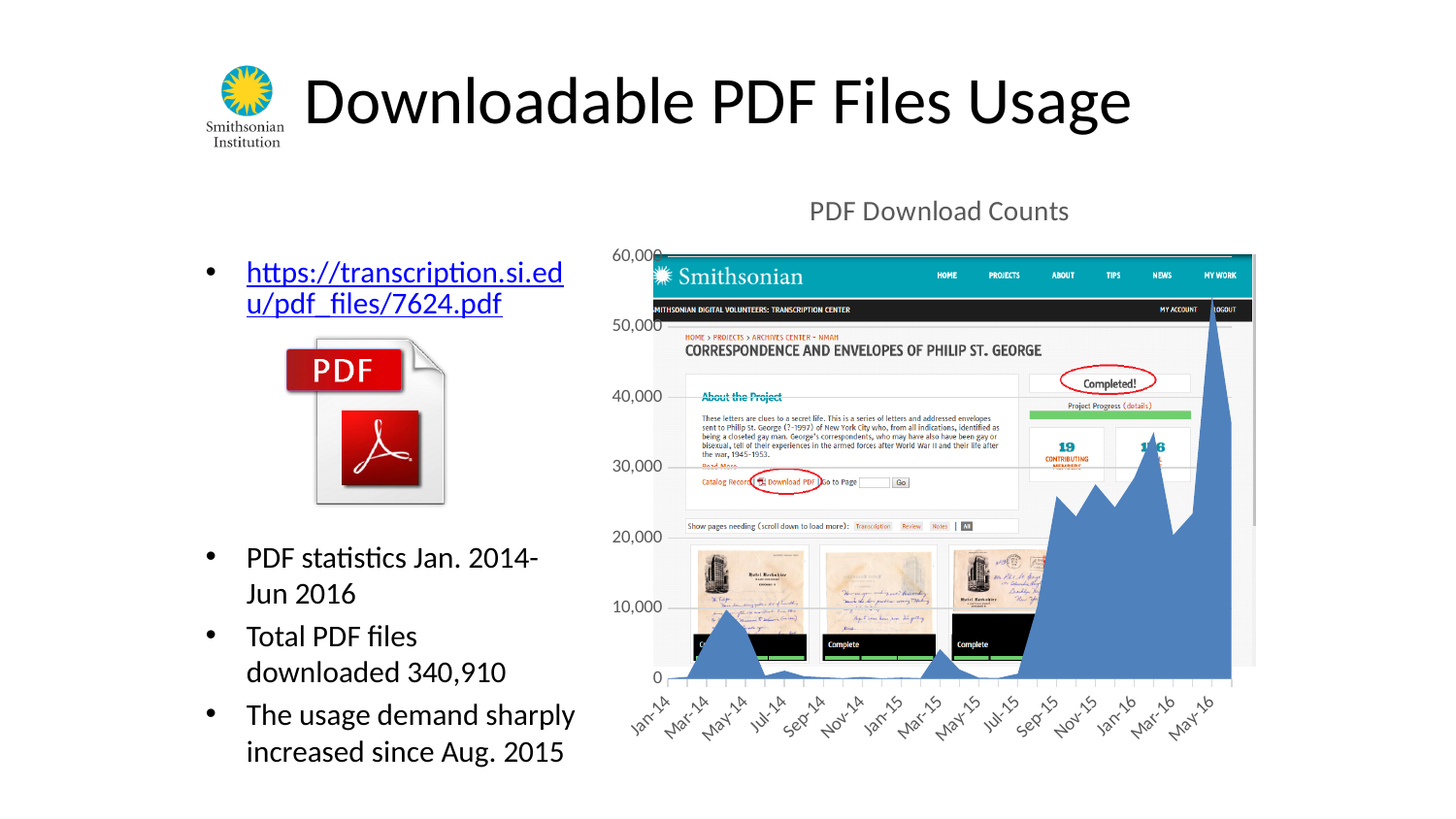
Is the value for Jul-15 greater or less than 10,000? less Is the value for Jan-15 greater or less than 10,000? less Is the value for Nov-15 greater or less than 20,000? greater How many month labels are shown along the x axis of the chart? 15 What kind of chart is shown on the slide? area chart What is the highest value shown on the chart's y axis? 60,000 What is the title of the chart? PDF Download Counts Overall, do the download counts rise or fall from Jan-14 to 2016? rise Which is larger, the value for Jan-16 or the value for Jan-15? Jan-16